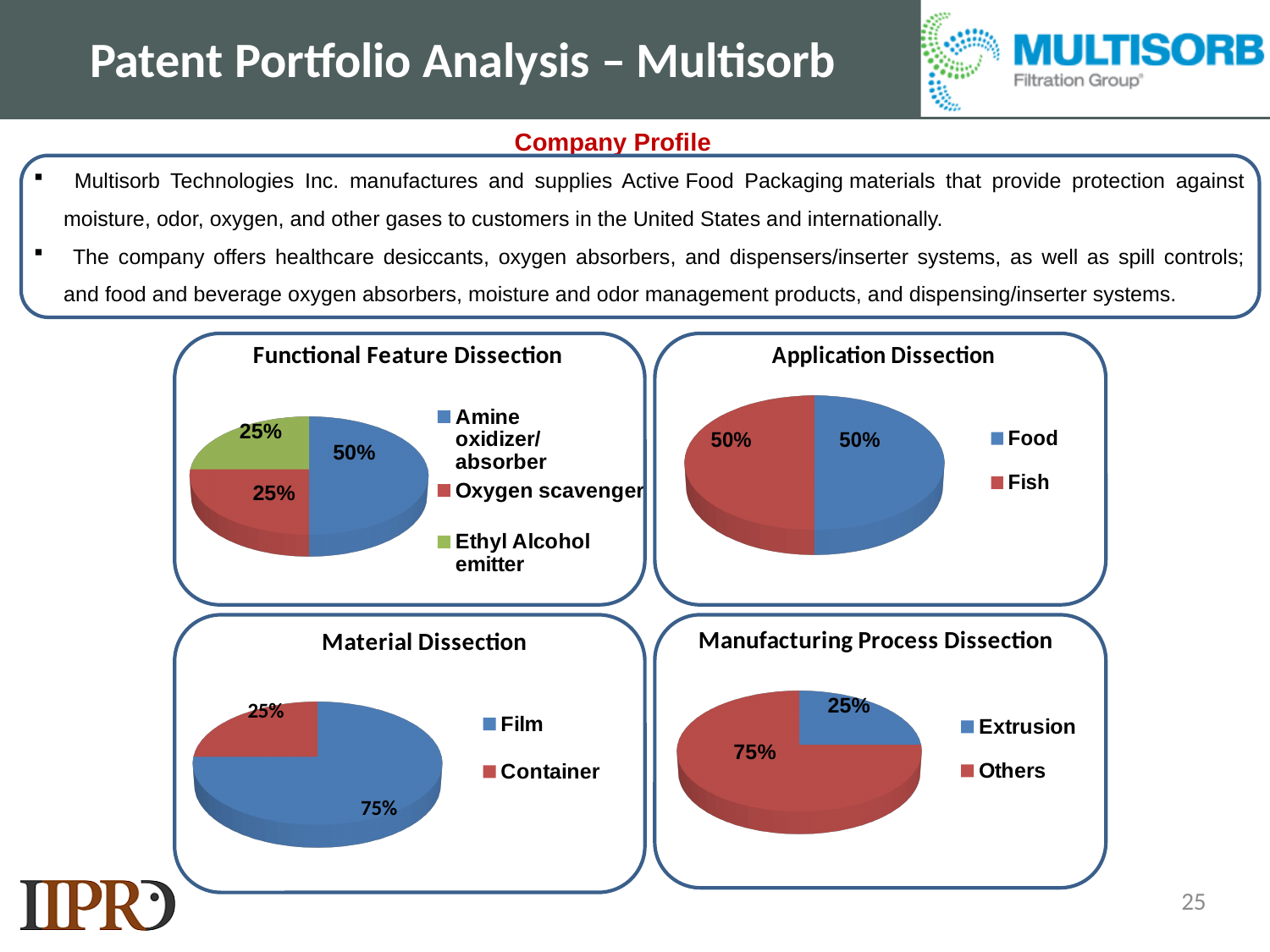
In the Material Dissection chart, what share does Film have? 75% In the Manufacturing Process Dissection chart, which is larger, Extrusion or Others? Others In the Manufacturing Process Dissection chart, what share does Others have? 75% In the Functional Feature Dissection chart, which category has the largest share? Amine oxidizer/absorber In the Functional Feature Dissection chart, what share does Amine oxidizer/absorber have? 50% How many categories does the Application Dissection chart show? 2 In the Material Dissection chart, what is the difference between the Film and Container shares? 50% What type of chart is the Manufacturing Process Dissection chart? Pie chart How many categories does the Functional Feature Dissection chart show? 3 In the Material Dissection chart, which category has the smallest share? Container